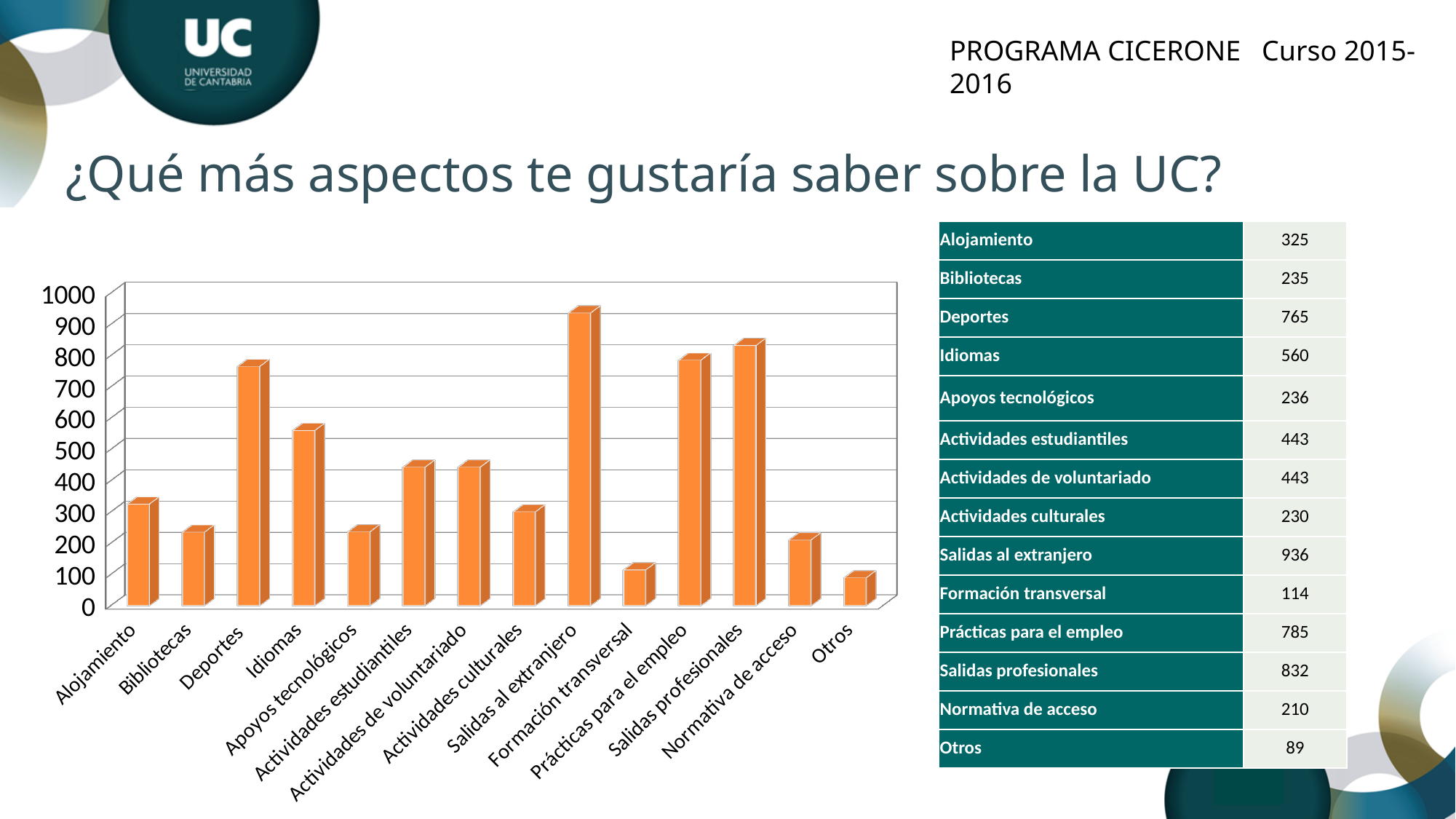
Which category has the lowest value in the chart? Otros Which category has the highest value in the chart? Salidas al extranjero Is the value for Normativa de acceso greater or less than 300? less What kind of chart is shown on the slide? bar chart How many categories are plotted in the bar chart? 14 Is the value for Idiomas greater or less than 500? greater Which is larger, the value for Prácticas para el empleo or the value for Deportes? Prácticas para el empleo What is the highest value shown on the vertical axis of the chart? 1000 What is the value for Salidas al extranjero? 936 What is the value for Formación transversal? 114 What is the value for Deportes? 765 What is the difference between the values for Salidas al extranjero and Salidas profesionales? 104